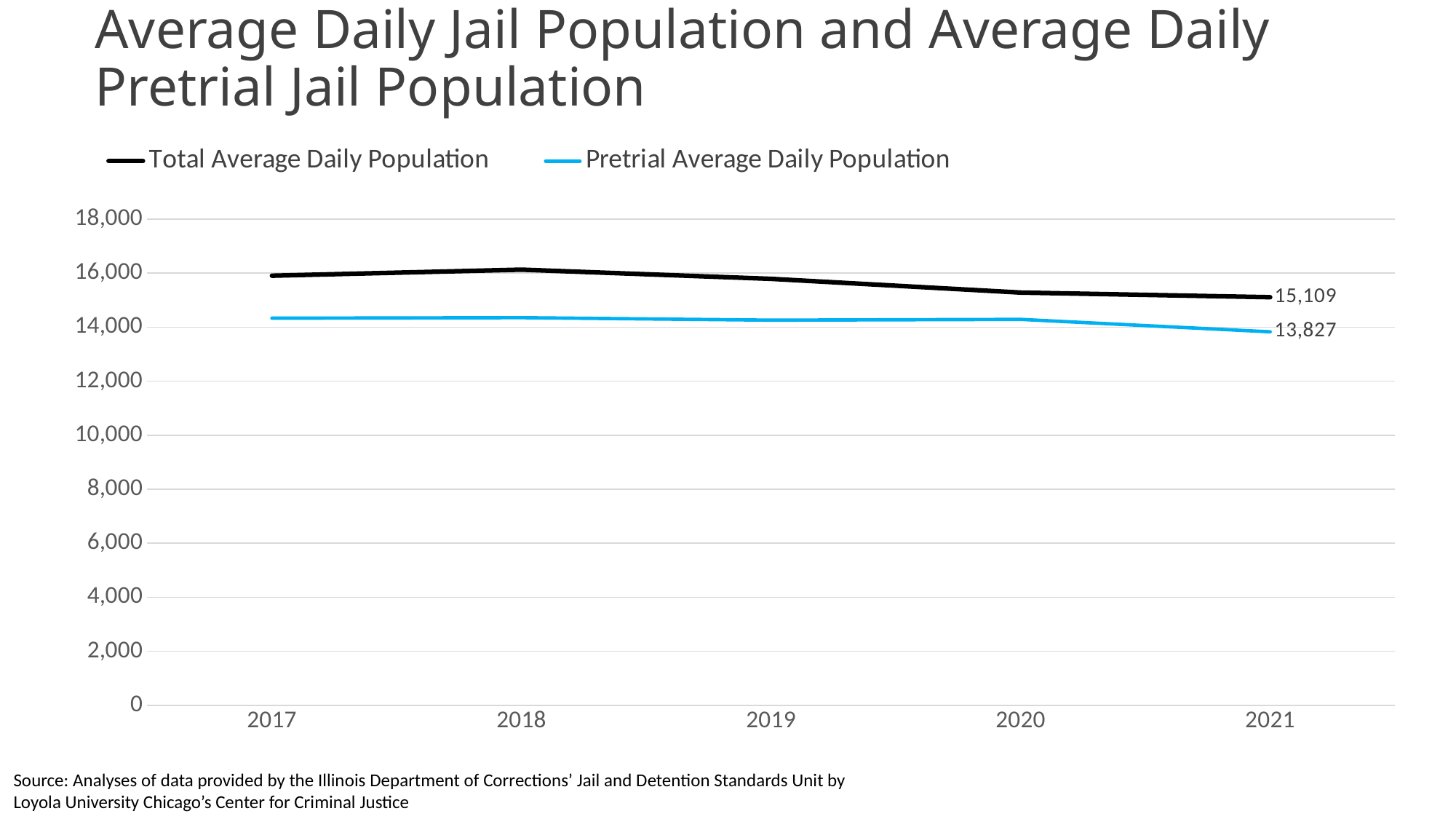
What is the Total Average Daily Population in 2021? 15,109 In 2021, which is larger: the Total Average Daily Population or the Pretrial Average Daily Population? Total Average Daily Population What is the Pretrial Average Daily Population in 2021? 13,827 In which year is the Total Average Daily Population lowest? 2021 Is the Total Average Daily Population in 2020 greater or less than 16,000? less Does the Total Average Daily Population rise or fall from 2018 to 2021? fall Is the Pretrial Average Daily Population in 2017 greater or less than 14,000? greater How many series does the legend list? 2 What kind of chart is shown on the slide? line chart How many years are shown on the x axis? 5 What is the difference between the Total Average Daily Population and the Pretrial Average Daily Population in 2021? 1,282